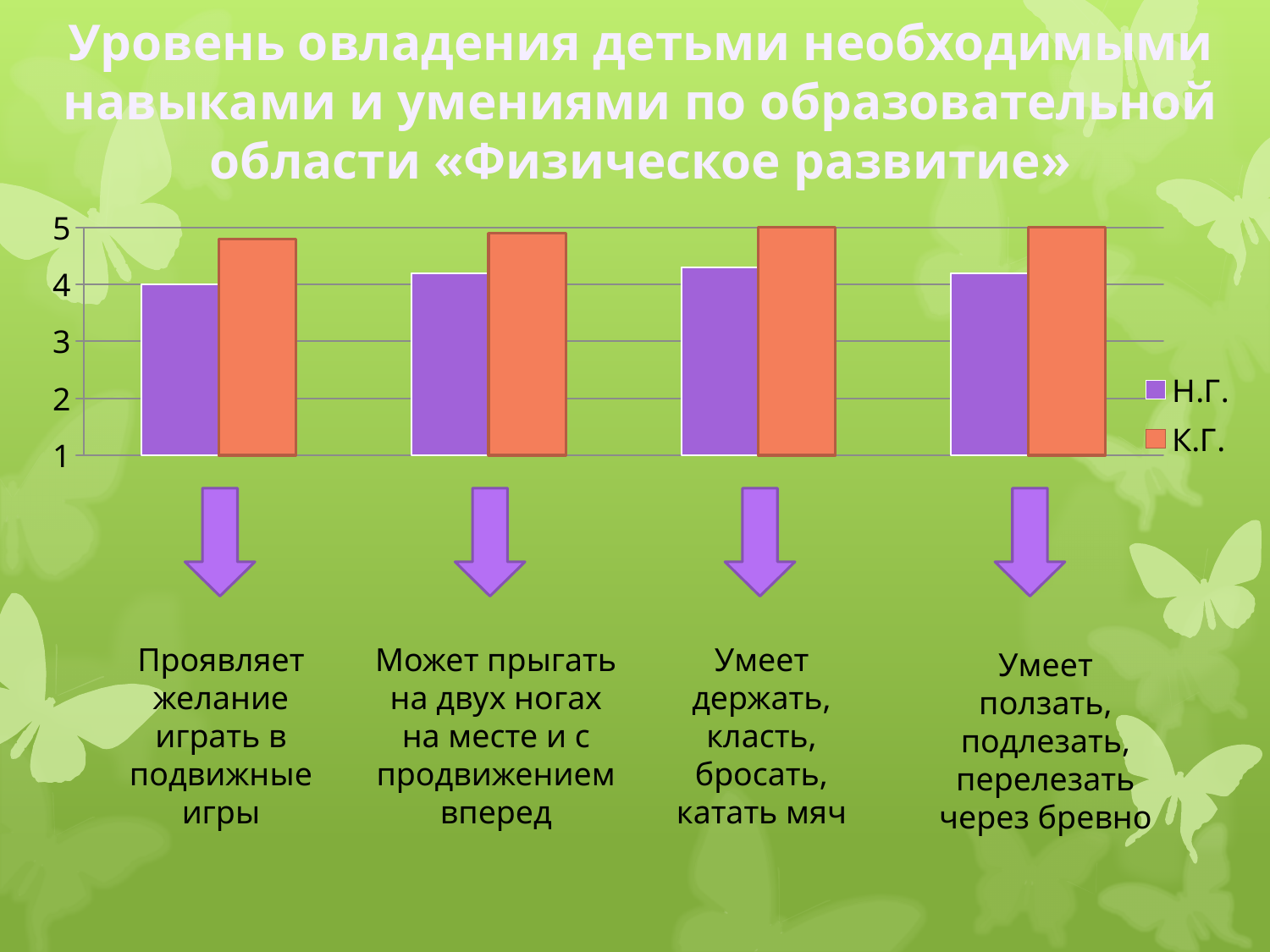
Is the К.Г. value for «Умеет держать, класть, бросать, катать мяч» greater or less than 4? greater What kind of chart is shown on the slide? bar chart What colour are the К.Г. bars? orange Is the Н.Г. value for «Проявляет желание играть в подвижные игры» greater or less than 3? greater How many series does the legend list? 2 How many categories (groups of bars) are plotted in the chart? 4 For the category «Проявляет желание играть в подвижные игры», which series has the larger value, Н.Г. or К.Г.? К.Г. In every category, which series is higher, Н.Г. or К.Г.? К.Г. Which category has the lowest Н.Г. value? Проявляет желание играть в подвижные игры Is the Н.Г. value for «Умеет ползать, подлезать, перелезать через бревно» greater or less than 5? less What are the two entries in the chart legend? Н.Г. and К.Г. What is the Н.Г. value for «Проявляет желание играть в подвижные игры»? 4